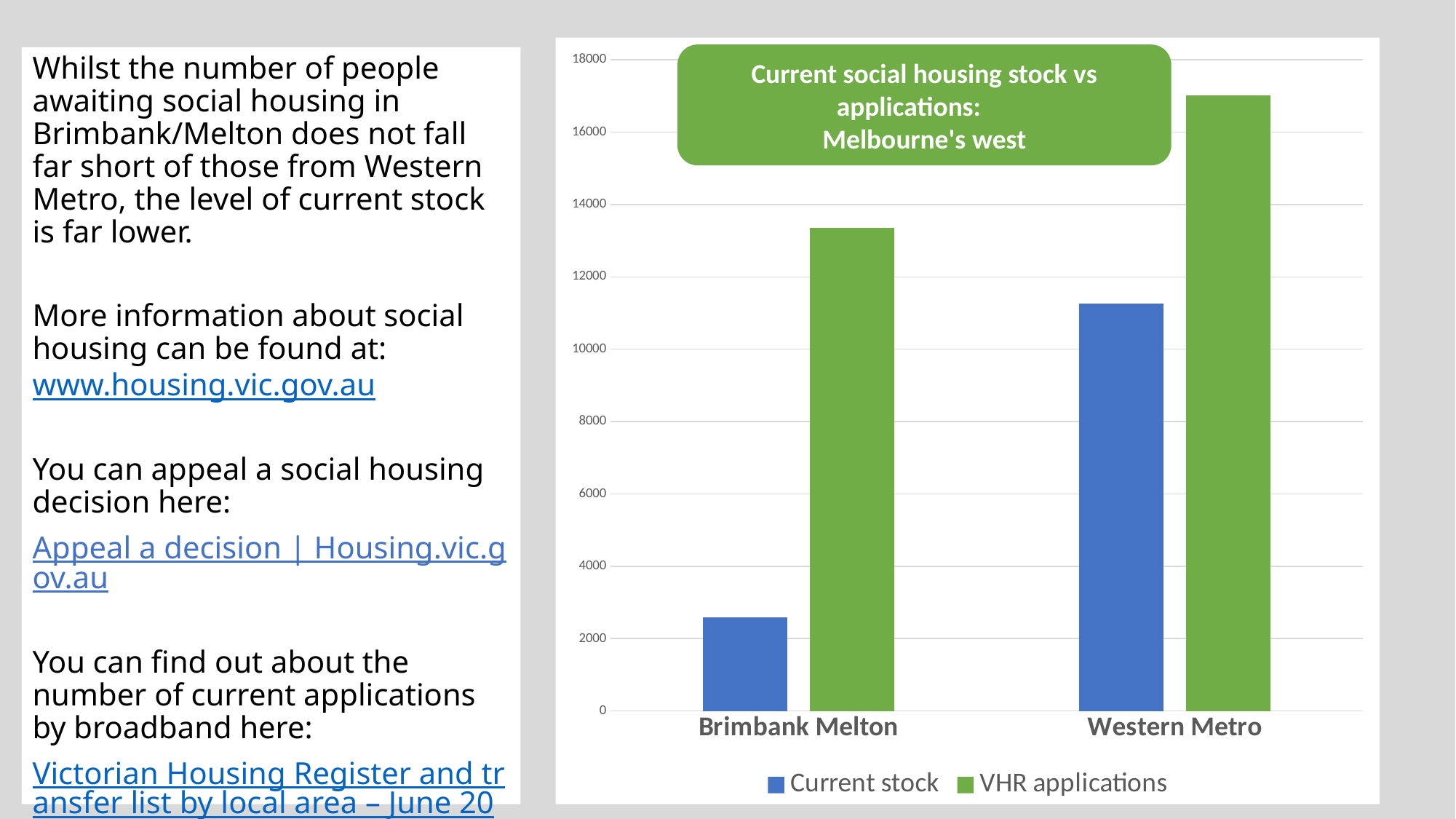
What kind of chart is shown on the slide? bar chart What is the title of the chart? Current social housing stock vs applications: Melbourne's west How many series does the chart legend list? 2 Which category has the higher Current stock value? Western Metro Is the Current stock value for Western Metro greater or less than 10000? greater For Brimbank Melton, which is larger: Current stock or VHR applications? VHR applications How many categories are shown on the x axis of the chart? 2 Which category has the lower VHR applications value? Brimbank Melton Is the Current stock value for Brimbank Melton greater or less than 4000? less Is the VHR applications value for Western Metro greater or less than 16000? greater Which series is shown in green in the chart? VHR applications